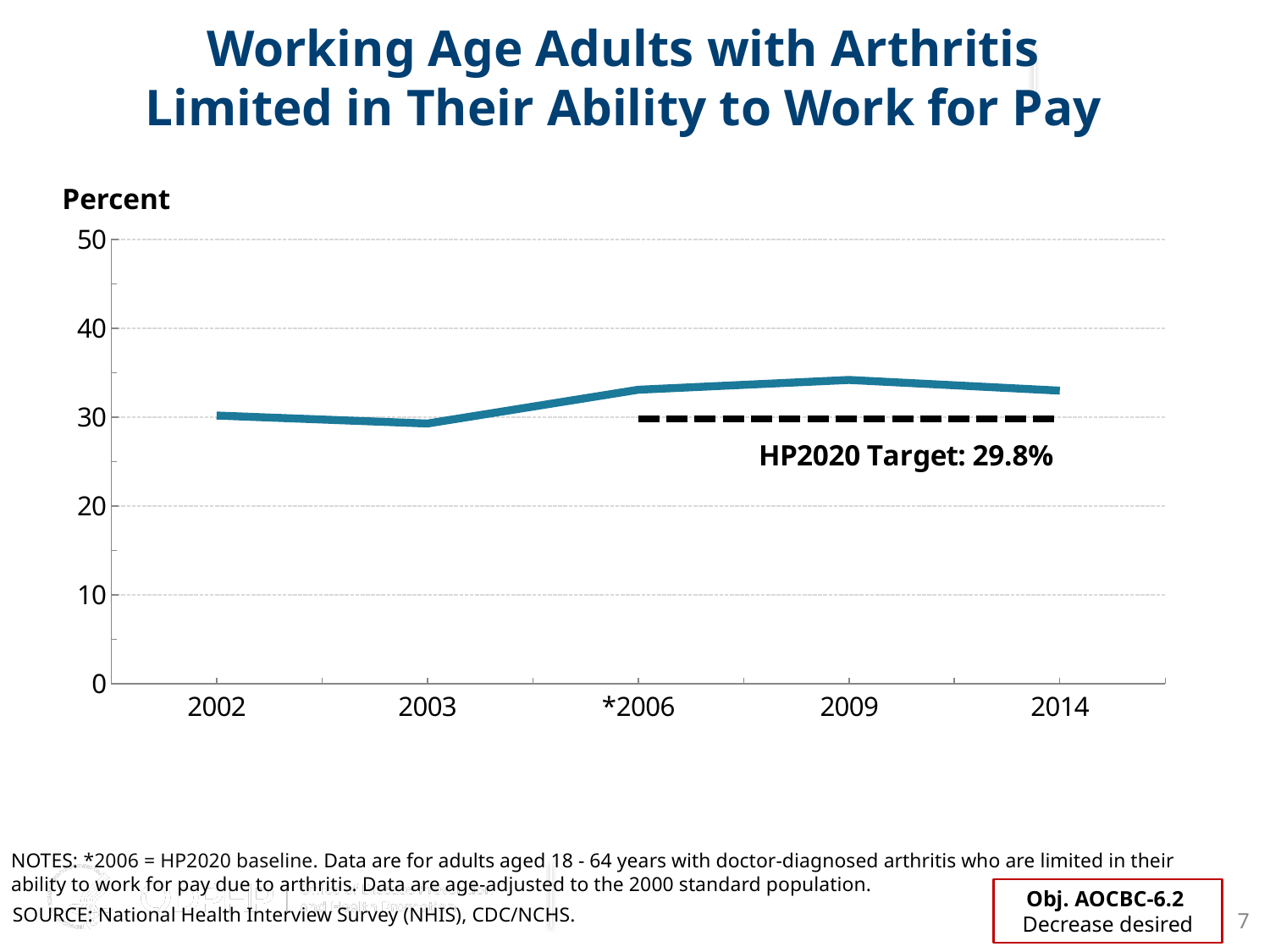
What kind of chart is shown on the slide? line chart Which year has the highest value? 2009 What is the label on the y axis? Percent Is the value for 2014 greater or less than 40? less Is the value for 2009 greater or less than 30? greater Does the value rise or fall from 2009 to 2014? fall Which is larger, the value for 2009 or the value for 2003? 2009 How many years are plotted on the x axis? 5 What is the HP2020 Target value shown on the chart? 29.8% Which year has the lowest value? 2003 Is the value for *2006 greater or less than 30? greater Does the value rise or fall from 2003 to 2009? rise